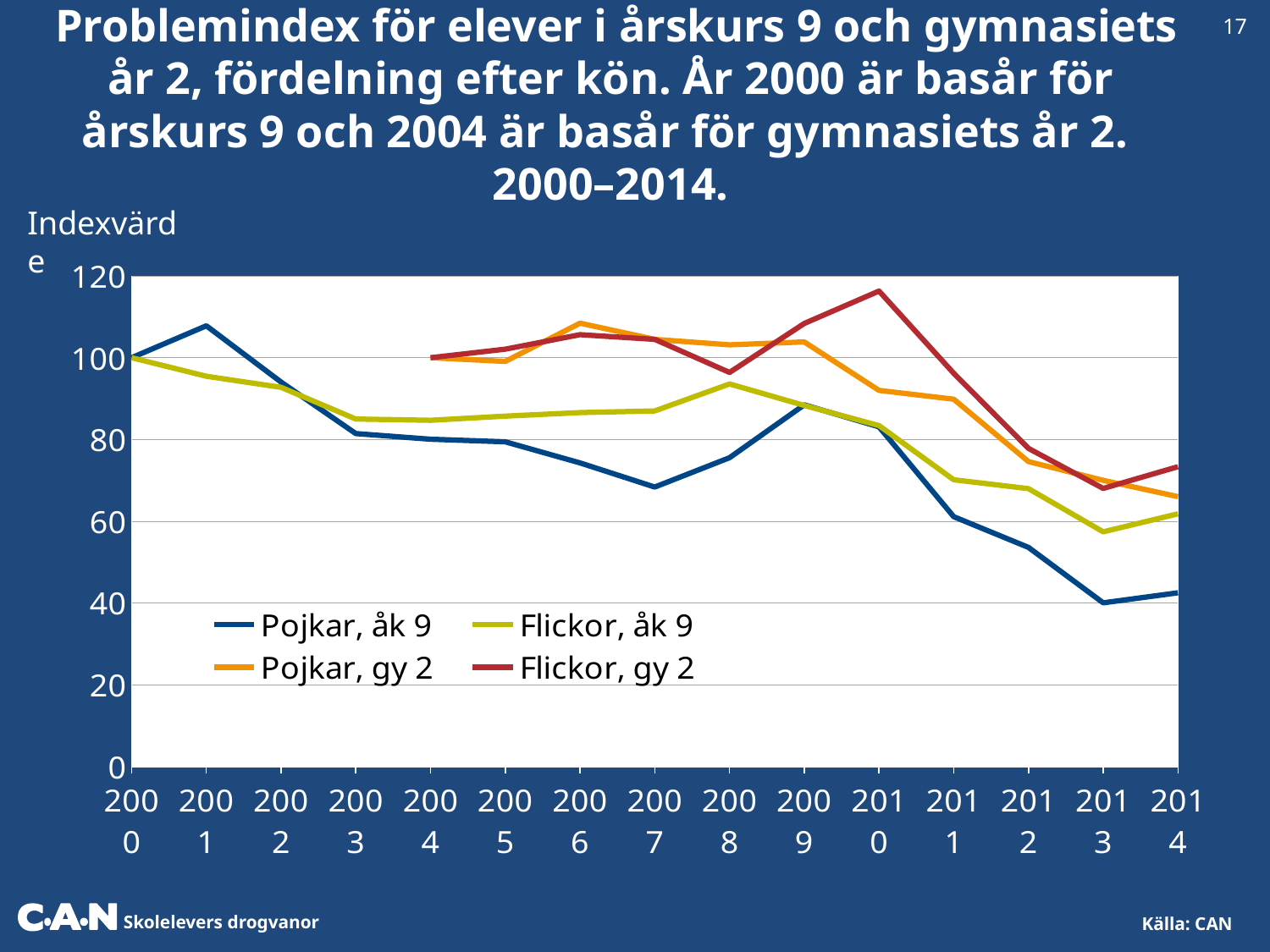
How many series does the legend list? 4 Is the value for Pojkar, åk 9 in 2001 greater or less than 100? greater Does the value for Pojkar, åk 9 rise or fall from 2010 to 2013? fall How many years are shown along the x axis? 15 Is the value for Pojkar, åk 9 in 2013 greater or less than 60? less In 2014, which is larger: the value for Flickor, gy 2 or the value for Pojkar, åk 9? Flickor, gy 2 What is the index value for Pojkar, gy 2 in 2004? 100 Which series has the lowest value in 2014? Pojkar, åk 9 Is the value for Flickor, gy 2 in 2010 greater or less than 100? greater What kind of chart is shown on the slide? line chart What is the index value for Pojkar, åk 9 in 2000? 100 Which series has the highest value in 2010? Flickor, gy 2